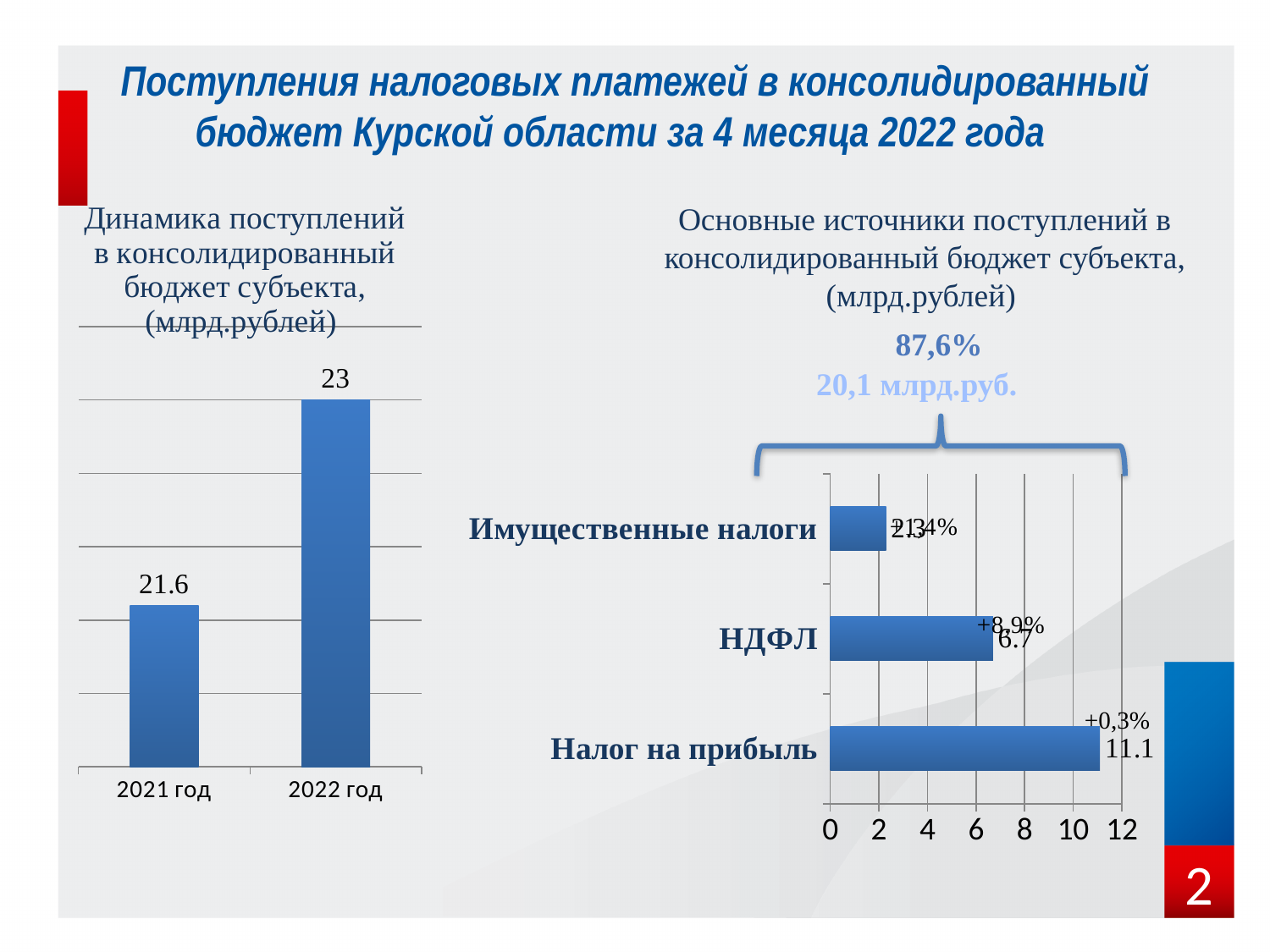
In the left chart (Динамика поступлений в консолидированный бюджет субъекта), which year has the higher value? 2022 год In the right chart (Основные источники поступлений в консолидированный бюджет субъекта), what is the value for НДФЛ? 6.7 In the right chart (Основные источники поступлений в консолидированный бюджет субъекта), how many categories are shown? 3 In the right chart (Основные источники поступлений в консолидированный бюджет субъекта), what is the value for Налог на прибыль? 11.1 In the right chart (Основные источники поступлений в консолидированный бюджет субъекта), which category has the lowest value? Имущественные налоги What kind of chart is the left chart (Динамика поступлений в консолидированный бюджет субъекта)? bar chart In the left chart (Динамика поступлений в консолидированный бюджет субъекта), by how much does the 2022 год value exceed the 2021 год value? 1.4 In the left chart (Динамика поступлений в консолидированный бюджет субъекта), do the values rise or fall from 2021 год to 2022 год? rise In the left chart (Динамика поступлений в консолидированный бюджет субъекта), what is the value for 2021 год? 21.6 In the right chart (Основные источники поступлений в консолидированный бюджет субъекта), is the value for Имущественные налоги greater or less than 4? less In the left chart (Динамика поступлений в консолидированный бюджет субъекта), what is the value for 2022 год? 23 In the right chart (Основные источники поступлений в консолидированный бюджет субъекта), which category has the highest value? Налог на прибыль